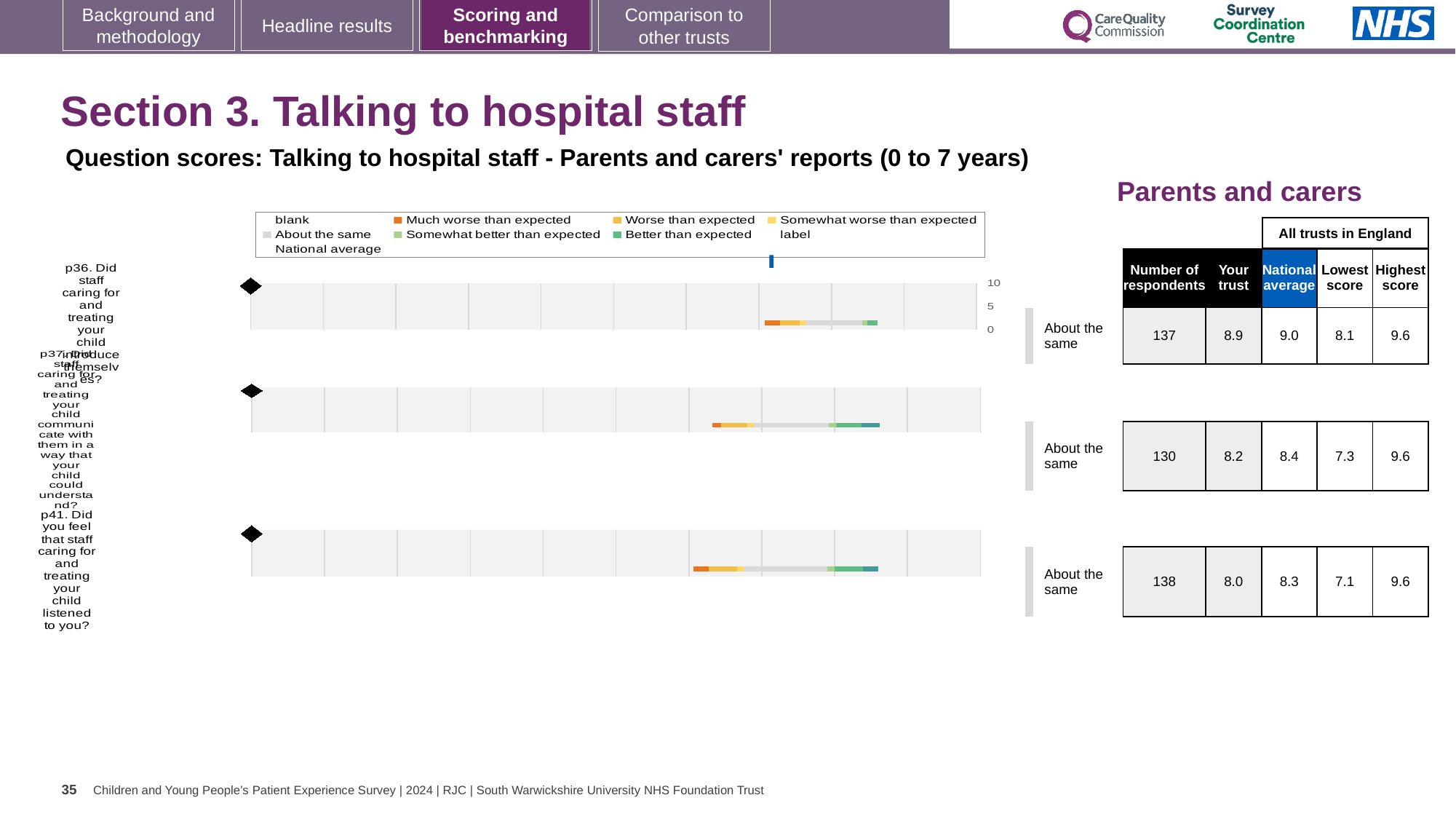
For the top chart (p36), which is larger: the 'Your trust' score or the national average? National average For the bottom chart (p41), how many respondents are shown in the table? 138 Which question row has the highest 'Your trust' score? p36 How many question rows (charts) are shown on the slide? 3 Which question row has the lowest 'Your trust' score? p41 For the middle chart (p37), what is the difference between the national average and the 'Your trust' score? 0.2 What colour does the legend use for 'Much worse than expected'? Orange What benchmark category label is shown beside each of the three charts? About the same For the top chart (p36), is the 'Your trust' score greater or less than 5? greater For the top chart (p36), what is the 'Your trust' score shown in the table? 8.9 For the middle chart (p37), what is the national average score shown in the table? 8.4 What kind of chart is used for the p36 question row? bar chart